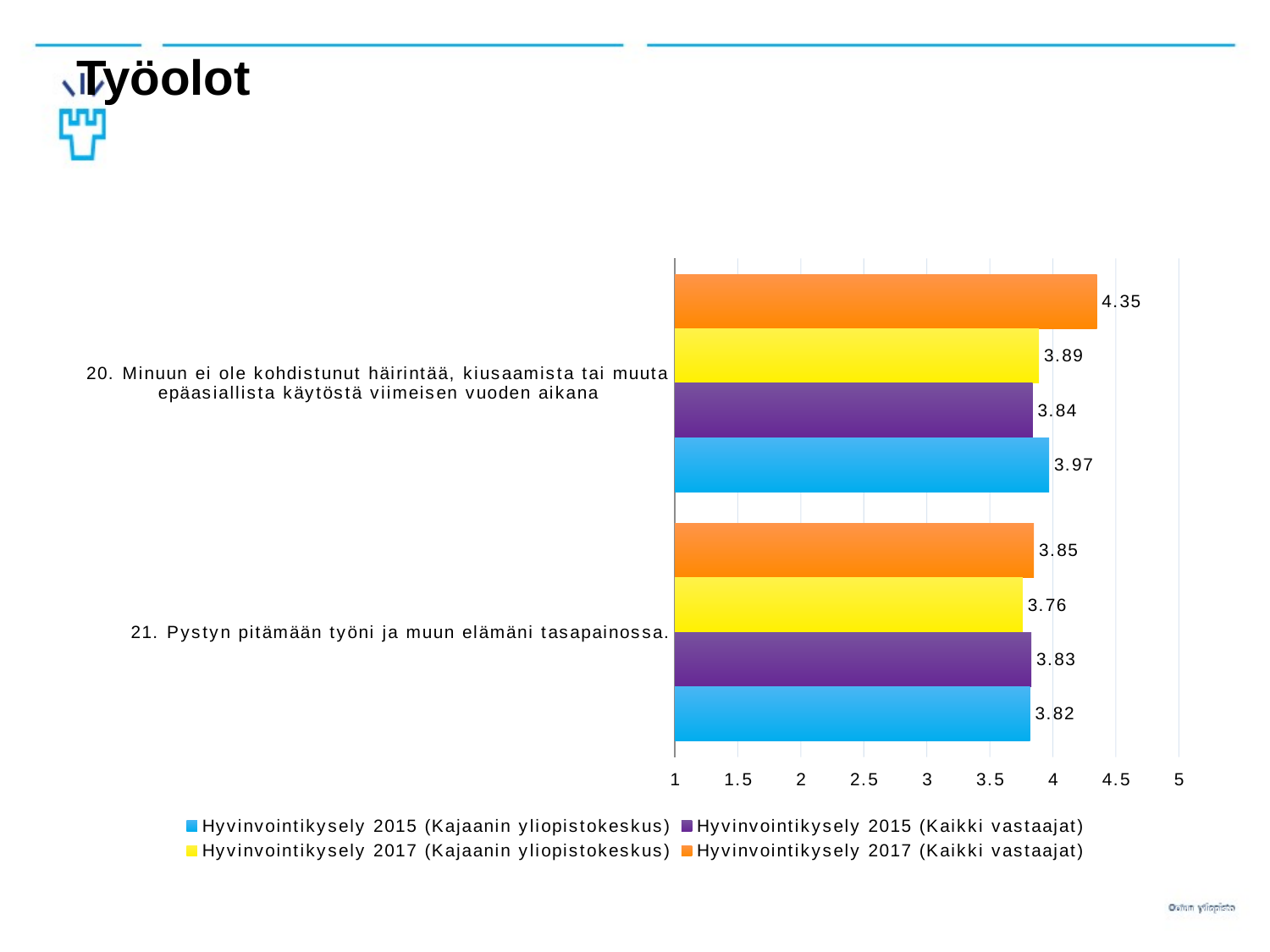
How many categories (statements) are plotted on the chart? 2 Which colour represents Hyvinvointikysely 2017 (Kaikki vastaajat) in the chart? orange How many series does the legend list? 4 Which series has the highest value for statement 20? Hyvinvointikysely 2017 (Kaikki vastaajat) What is the value for Hyvinvointikysely 2015 (Kajaanin yliopistokeskus) for statement 21 (Pystyn pitämään työni ja muun elämäni tasapainossa)? 3.82 What kind of chart is shown on the slide? bar chart What is the difference between the Hyvinvointikysely 2017 (Kaikki vastaajat) values for statement 20 and statement 21? 0.50 For statement 20, which is larger: the Hyvinvointikysely 2015 (Kajaanin yliopistokeskus) value or the Hyvinvointikysely 2017 (Kajaanin yliopistokeskus) value? Hyvinvointikysely 2015 (Kajaanin yliopistokeskus) What is the value for Hyvinvointikysely 2017 (Kajaanin yliopistokeskus) for statement 21? 3.76 What is the value for Hyvinvointikysely 2017 (Kaikki vastaajat) for statement 20 (Minuun ei ole kohdistunut häirintää...)? 4.35 What is the value for Hyvinvointikysely 2015 (Kaikki vastaajat) for statement 20? 3.84 Which series has the lowest value for statement 21? Hyvinvointikysely 2017 (Kajaanin yliopistokeskus)